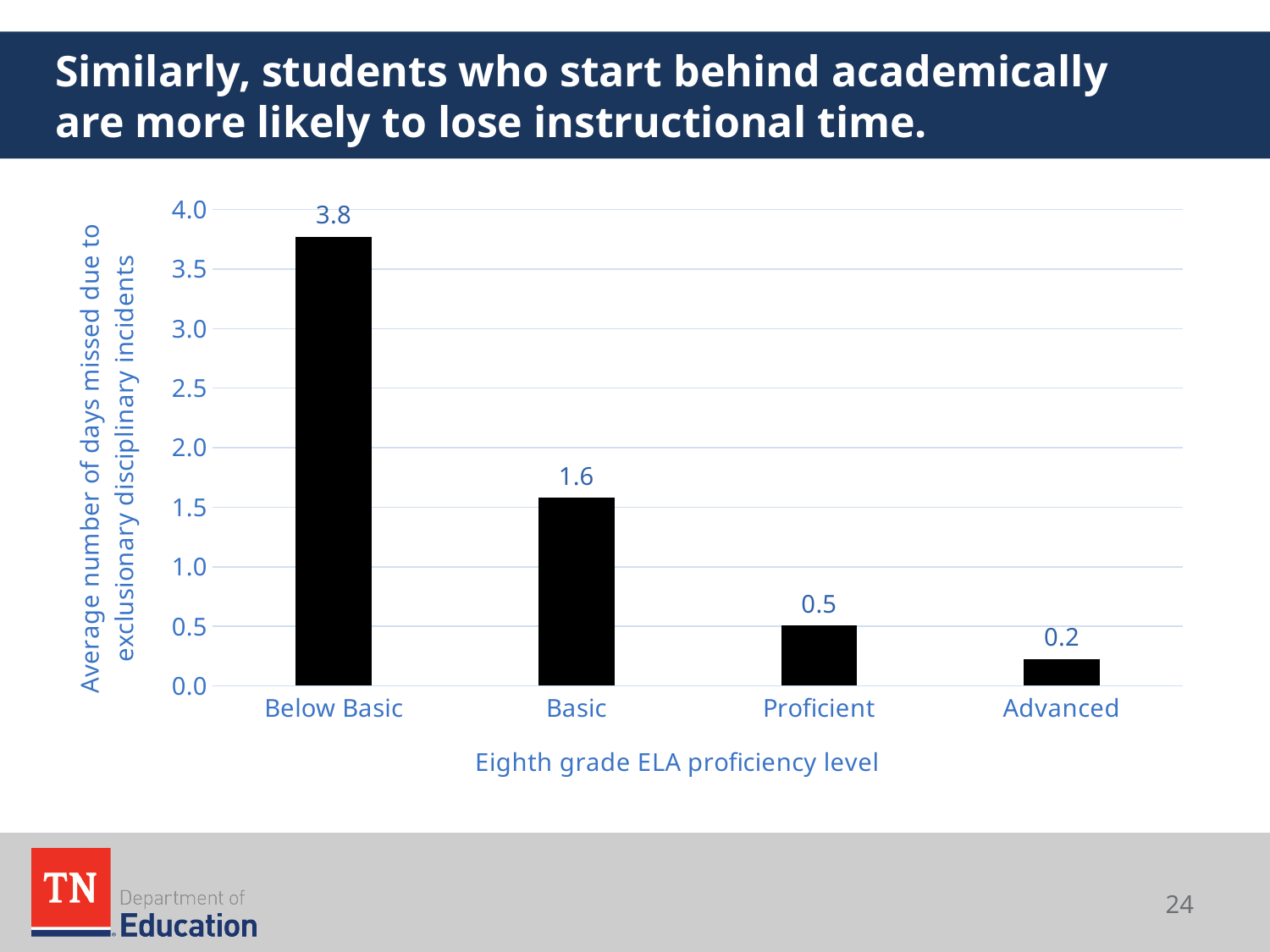
Do the values rise or fall as proficiency level increases from Below Basic to Advanced? Fall How many proficiency levels are shown on the x axis? 4 Which proficiency level has the highest average number of days missed? Below Basic What is the average number of days missed for students at the Advanced level? 0.2 What is the average number of days missed for students at the Proficient level? 0.5 What kind of chart is shown on the slide? Bar chart Which has a higher average number of days missed, Proficient or Advanced? Proficient Which proficiency level has the lowest average number of days missed? Advanced What is the average number of days missed due to exclusionary disciplinary incidents for students at the Below Basic proficiency level? 3.8 What is the average number of days missed for students at the Basic proficiency level? 1.6 What is the difference in average days missed between Below Basic and Basic students? 2.2 Is the value for Basic greater or less than 2.0? less